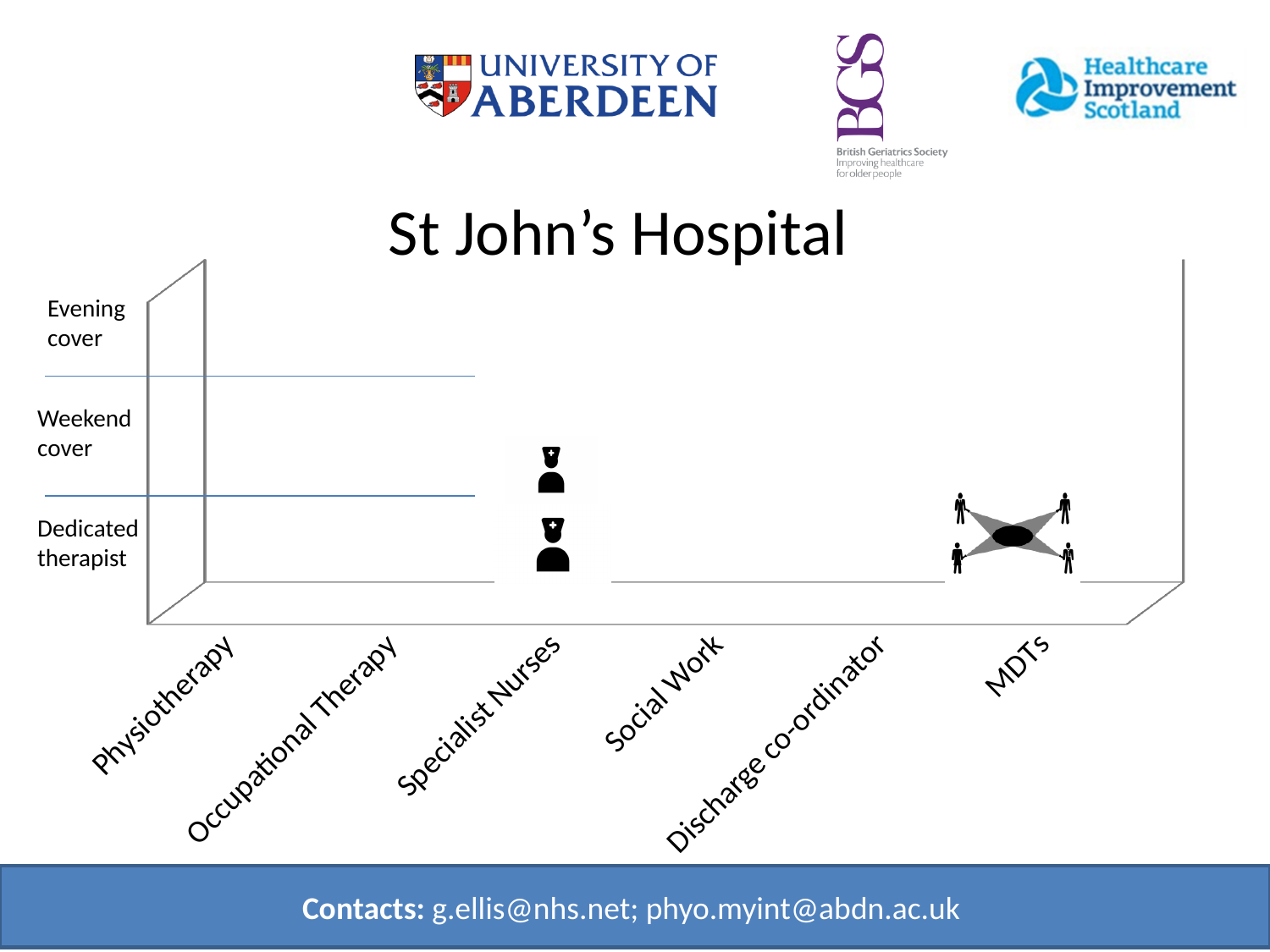
Does the icon for MDTs reach above the 'Dedicated therapist' level on the y axis? No Does any category reach the 'Evening cover' level? No How many nurse icons are stacked for Specialist Nurses? 2 Which has more icons, Specialist Nurses or MDTs? Specialist Nurses What are the three levels labelled on the y axis, from bottom to top? Dedicated therapist, Weekend cover, Evening cover How many icons are shown for MDTs? 1 What is the label of the last category on the x axis? MDTs Does the stack for Specialist Nurses reach the 'Weekend cover' level on the y axis? Yes What is the title of the chart? St John's Hospital Which categories have no icons plotted at all? Physiotherapy, Occupational Therapy, Social Work, Discharge co-ordinator Which category has the tallest stack of icons in the chart? Specialist Nurses How many categories are shown along the x axis of the chart? 6